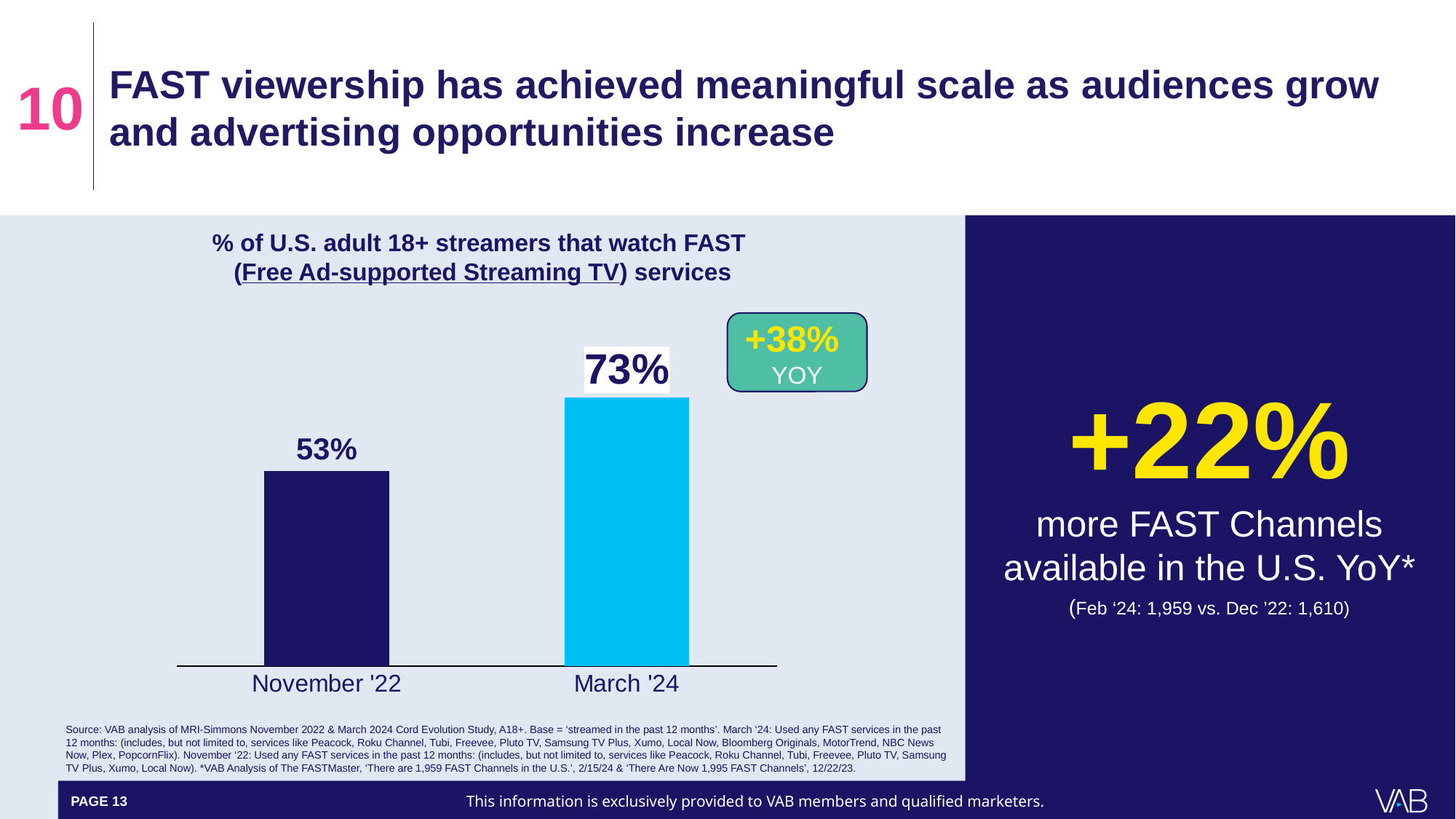
How many bars are shown in the chart? 2 What is the title of the chart? % of U.S. adult 18+ streamers that watch FAST (Free Ad-supported Streaming TV) services What year-over-year change is shown in the callout box next to the chart? +38% Do the values rise or fall from November '22 to March '24? rise What percentage of U.S. adult 18+ streamers watched FAST services in November '22? 53% What type of chart is used to show the share of streamers watching FAST services? bar chart Is the value for November '22 larger or smaller than the value for March '24? smaller What percentage of U.S. adult 18+ streamers watched FAST services in March '24? 73% Which period has the higher share of streamers watching FAST services? March '24 What is the difference in percentage points between the March '24 and November '22 values? 20 Which period has the lower share of streamers watching FAST services? November '22